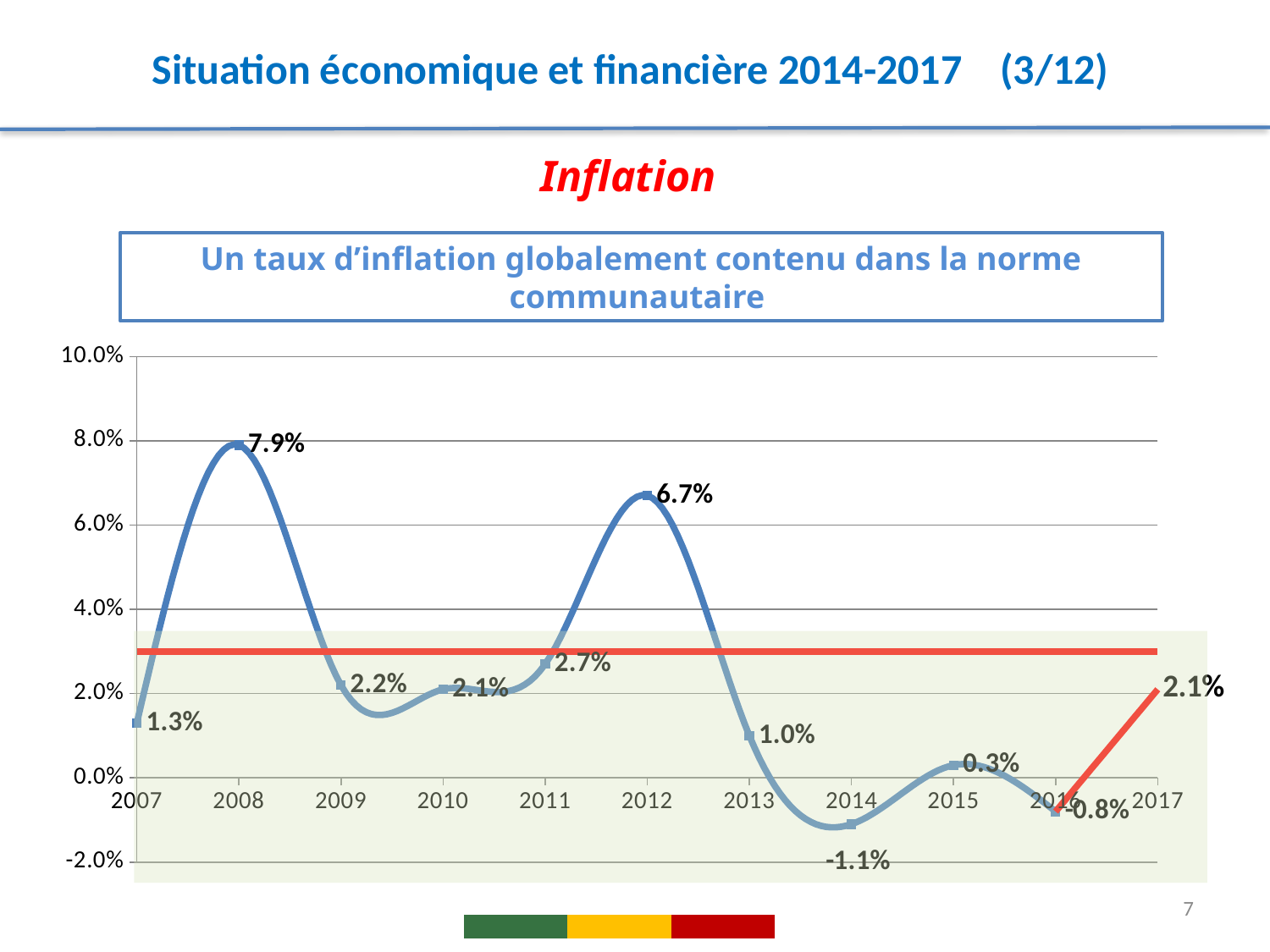
What is the title shown in red above the chart? Inflation What is the inflation rate shown for 2017? 2.1% How many years are plotted on the x axis of the chart? 11 Is the inflation rate for 2012 greater or less than 6.0%? greater Which year has the lowest inflation rate on the chart? 2014 Which year has the highest inflation rate on the chart? 2008 What is the inflation rate shown for 2008? 7.9% What is the inflation rate shown for 2014? -1.1% Does the inflation rate rise or fall from 2016 to 2017? rise What is the difference between the inflation rates for 2008 and 2012? 1.2% What kind of chart is used to show the inflation rates? line chart Which year has a higher inflation rate, 2011 or 2013? 2011